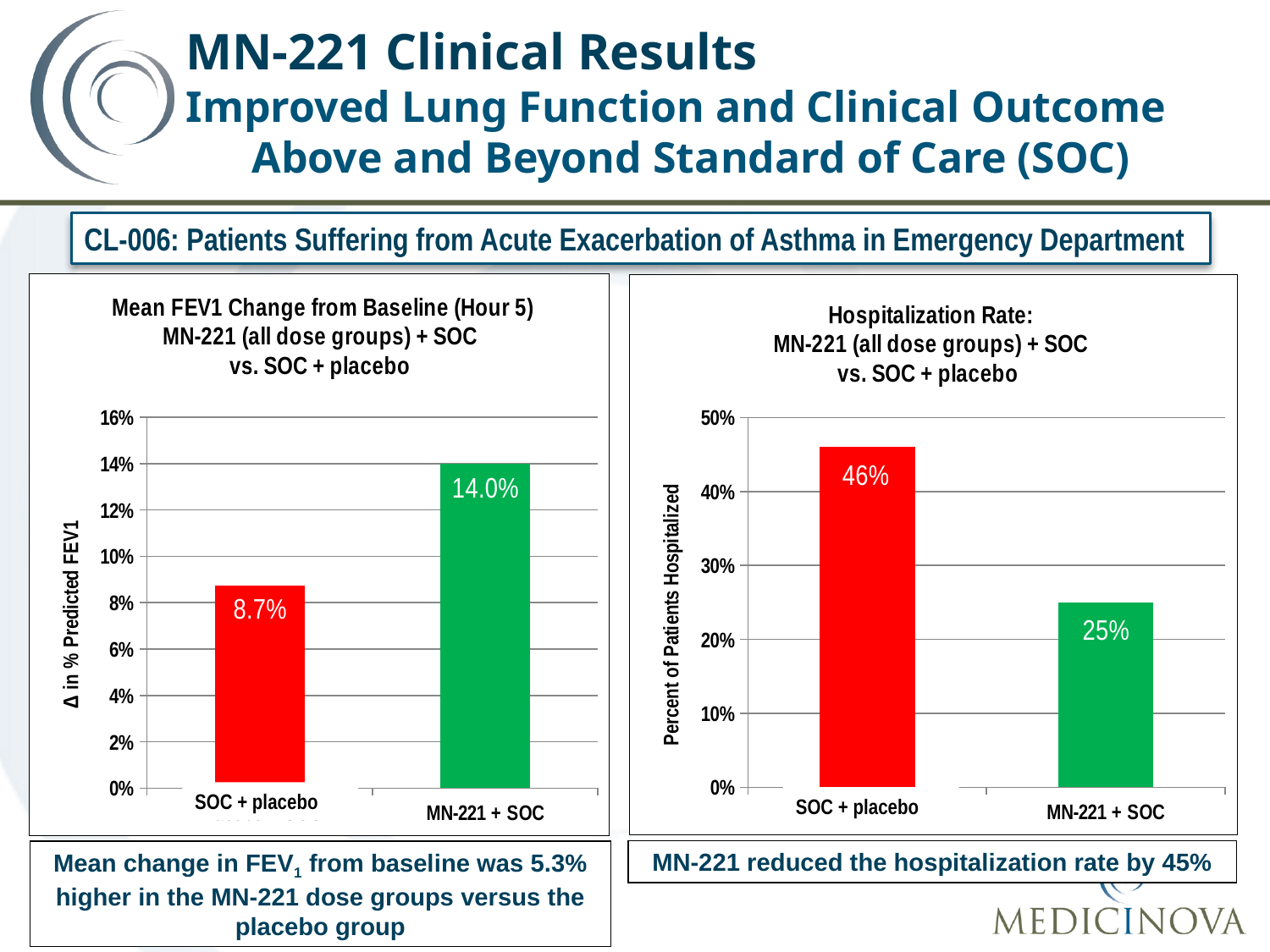
In the Hospitalization Rate chart, what is the value for SOC + placebo? 46% In the Mean FEV1 Change from Baseline chart, what is the difference between MN-221 + SOC and SOC + placebo? 5.3% In the Hospitalization Rate chart, what is the value for MN-221 + SOC? 25% How many categories are shown in the Hospitalization Rate chart? 2 What kind of chart is the Mean FEV1 Change from Baseline chart? Bar chart In the Mean FEV1 Change from Baseline chart, which category has the highest value? MN-221 + SOC In the Hospitalization Rate chart, which is larger, SOC + placebo or MN-221 + SOC? SOC + placebo In the Mean FEV1 Change from Baseline chart, what is the value for SOC + placebo? 8.7% In the Mean FEV1 Change from Baseline chart, is the value for SOC + placebo greater or less than 10%? less In the Hospitalization Rate chart, what is the difference between SOC + placebo and MN-221 + SOC? 21% In the Mean FEV1 Change from Baseline chart, what is the value for MN-221 + SOC? 14.0% In the Hospitalization Rate chart, which category has the lowest value? MN-221 + SOC